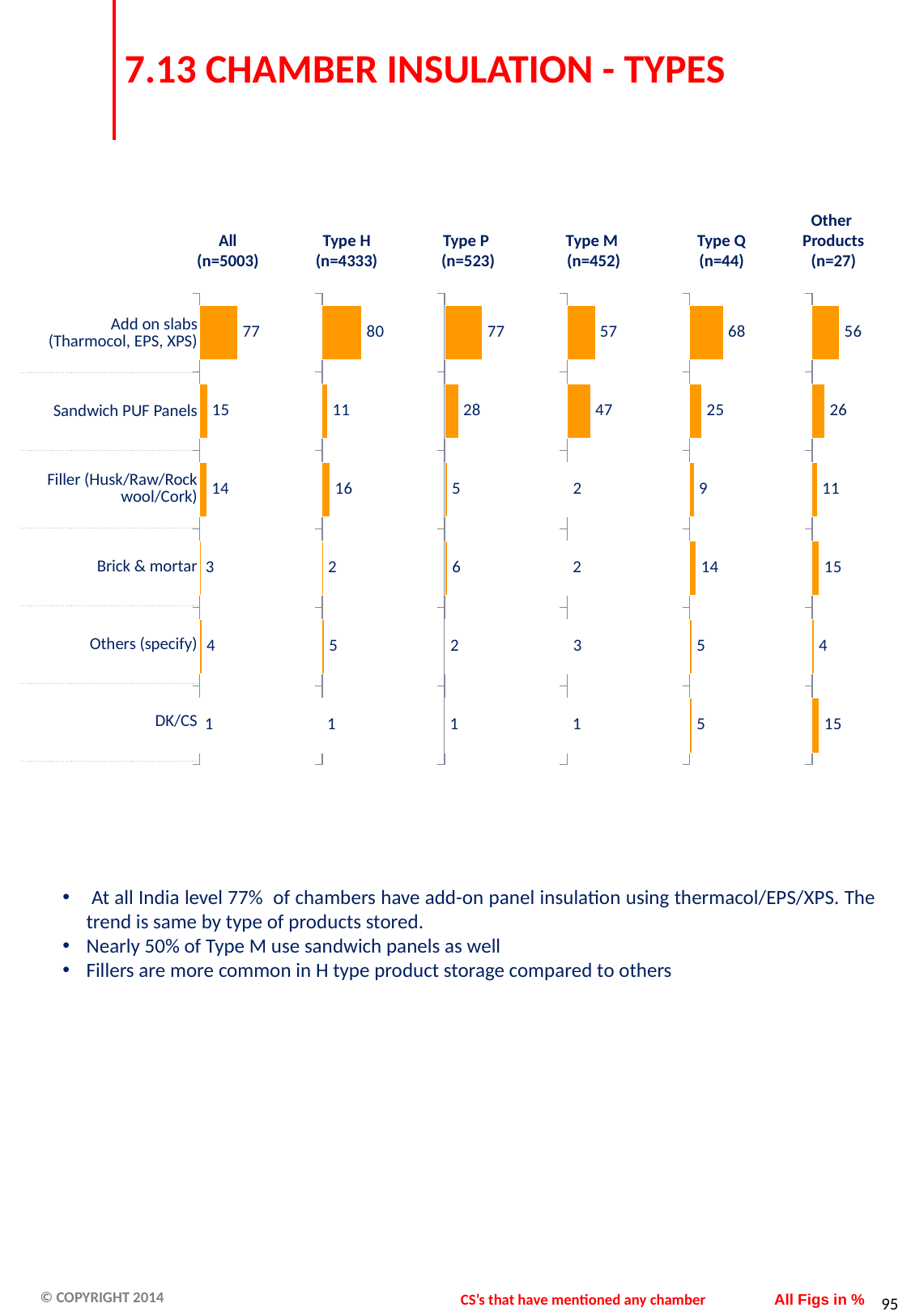
In the Other Products (n=27) chart, what is the value for DK/CS? 15 In the Type M (n=452) chart, what is the value for Sandwich PUF Panels? 47 What kind of chart is used in the Type H (n=4333) column? Bar chart In the Type H (n=4333) chart, which category has the highest value? Add on slabs (Tharmocol, EPS, XPS) In the Type P (n=523) chart, which category has the lowest value? DK/CS In the Type Q (n=44) chart, what is the difference between Add on slabs (Tharmocol, EPS, XPS) and Sandwich PUF Panels? 43 How many categories are shown in each of the bar charts on the slide? 6 What is the sample size (n) shown for the Type Q chart? n=44 In the Other Products (n=27) chart, which is larger: Brick & mortar or Filler (Husk/Raw/Rock wool/Cork)? Brick & mortar In the Type H (n=4333) chart, what is the value for Filler (Husk/Raw/Rock wool/Cork)? 16 How many separate bar charts (columns) are shown on the slide? 6 In the All (n=5003) chart, what is the value for Add on slabs (Tharmocol, EPS, XPS)? 77